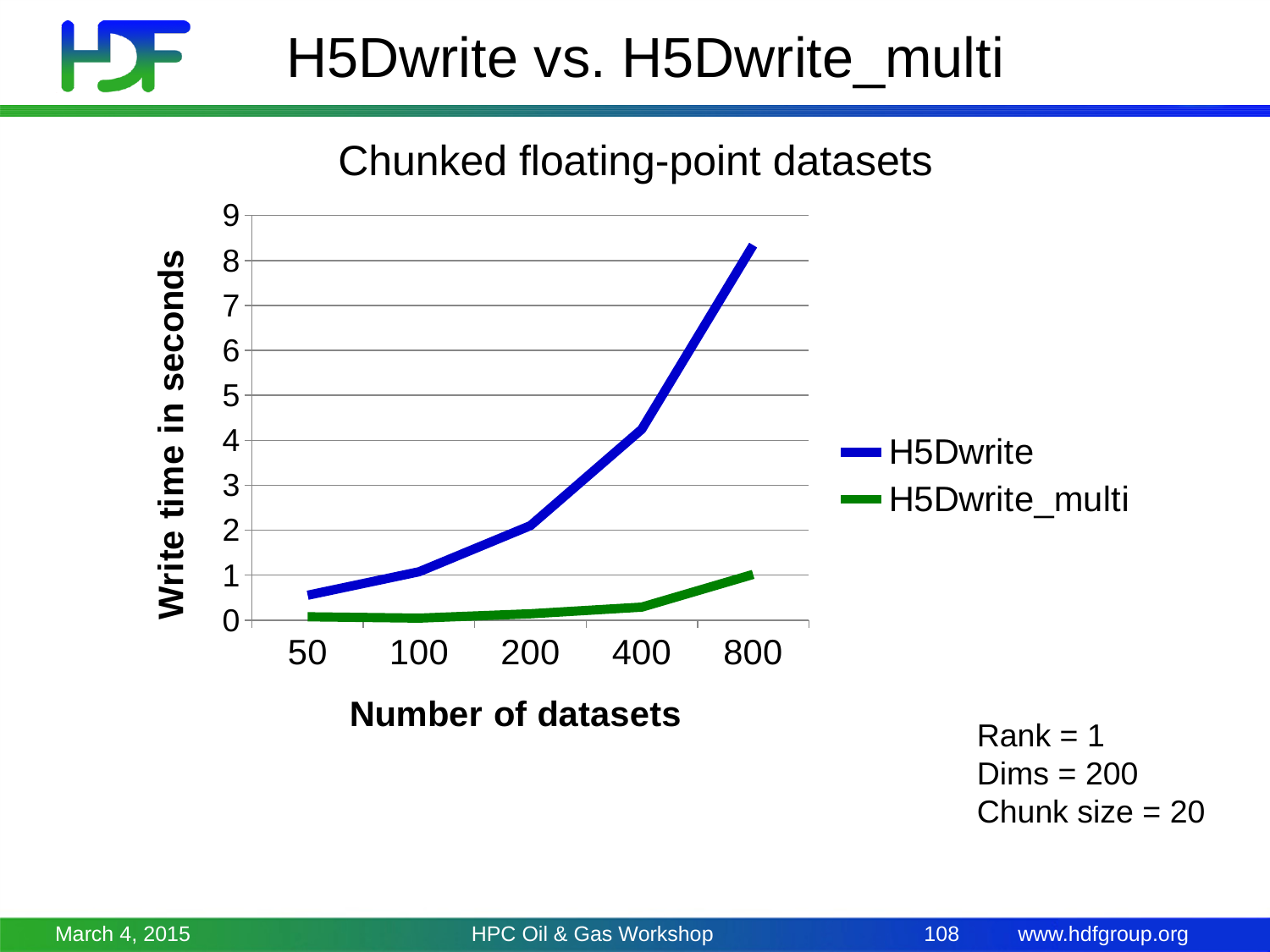
Does the H5Dwrite write time rise or fall as the number of datasets increases? rise Is the H5Dwrite write time at 800 datasets greater or less than 7 seconds? greater Is the H5Dwrite_multi write time at 800 datasets greater or less than 2 seconds? less Is the H5Dwrite write time at 50 datasets greater or less than 1 second? less At 800 datasets, which series has the larger write time, H5Dwrite or H5Dwrite_multi? H5Dwrite At which number of datasets is the H5Dwrite write time highest? 800 How many values of Number of datasets are plotted along the x axis? 5 What is the title of the chart? Chunked floating-point datasets How many series does the legend list? 2 What kind of chart is shown on the slide? line chart